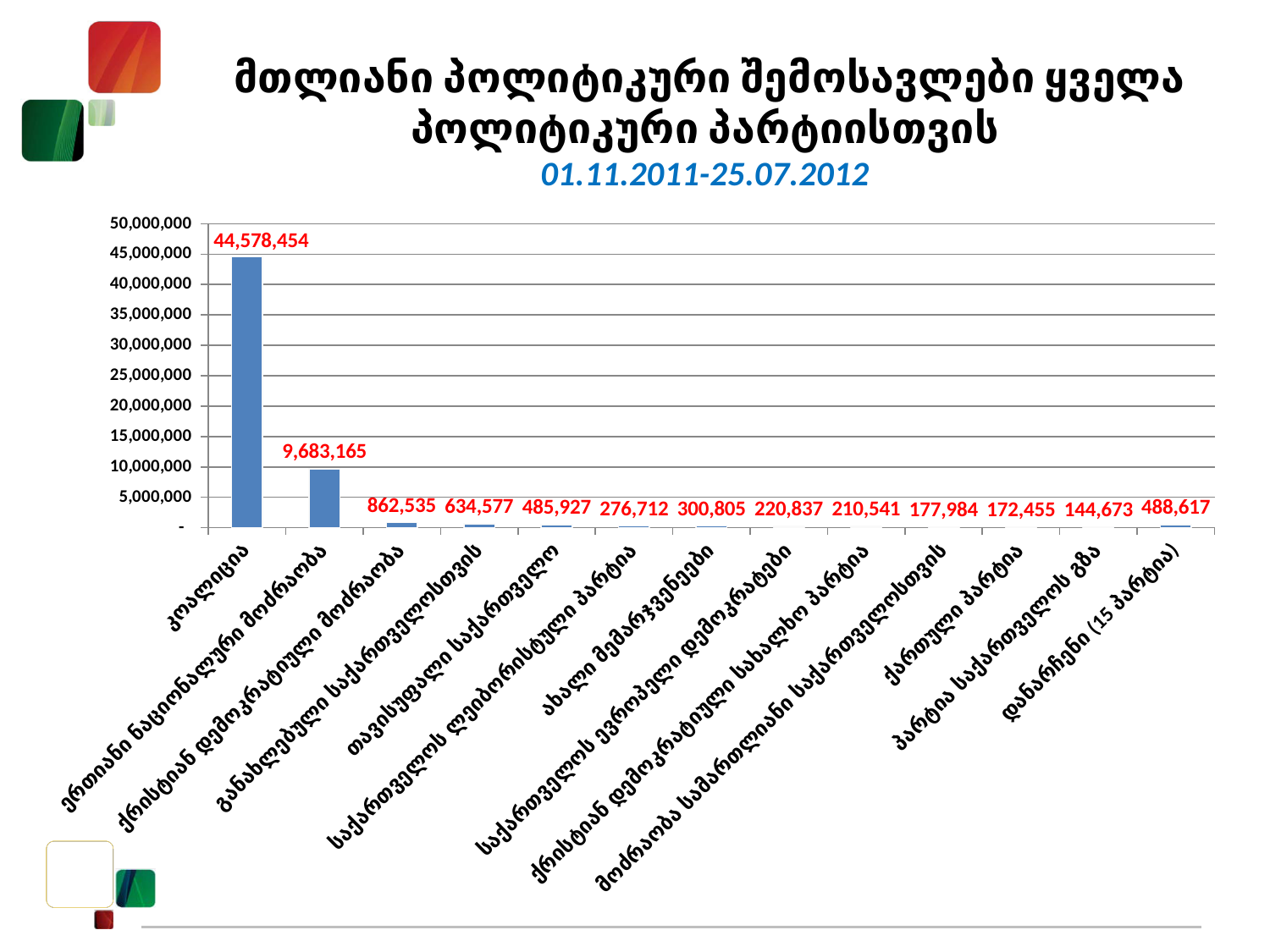
What is the value for დანარჩენი (15 პარტია)? 488,617 What is the value for ქრისტიან დემოკრატიული მოძრაობა? 862,535 What is the value for კოალიცია? 44,578,454 What is the difference between the values for კოალიცია and ერთიანი ნაციონალური მოძრაობა? 34,895,289 What type of chart is shown on the slide? bar chart Which category has the lowest value? პარტია საქართველოს გზა What is the value for ერთიანი ნაციონალური მოძრაობა? 9,683,165 Which category has the highest value? კოალიცია Is the value for ერთიანი ნაციონალური მოძრაობა greater or less than 5,000,000? greater Which is larger, the value for ახალი მემარჯვენეები or the value for საქართველოს ლეიბორისტული პარტია? ახალი მემარჯვენეები How many categories are shown on the x axis? 13 What period is given in the subtitle of the chart? 01.11.2011-25.07.2012